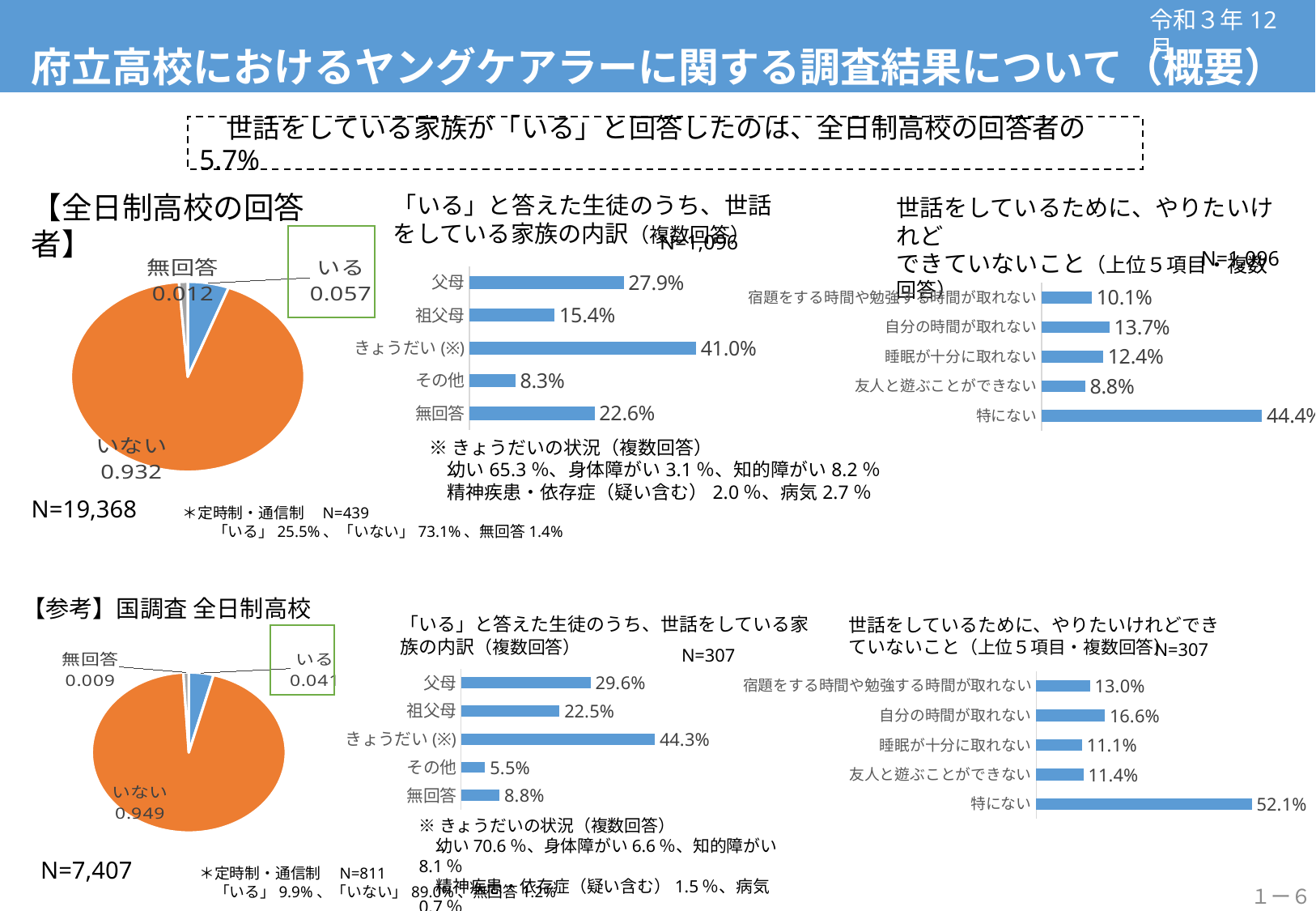
In the bottom-middle bar chart (国調査, N=307), what is the value for きょうだい (※)? 44.3% How many categories are shown in the bottom-right bar chart (国調査, N=307)? 5 In the top-left pie chart (全日制高校の回答者), what share is labelled for いない? 0.932 In the top-middle bar chart (世話をしている家族の内訳, N=1,096), what is the difference between 父母 and その他? 19.6% In the top-right bar chart (やりたいけれどできていないこと, N=1,096), what is the value for 睡眠が十分に取れない? 12.4% In the bottom-right bar chart (国調査, N=307), what is the value for 特にない? 52.1% In the bottom-middle bar chart (国調査, N=307), which is larger, 祖父母 or 無回答? 祖父母 In the top-middle bar chart (世話をしている家族の内訳, N=1,096), which category has the highest value? きょうだい (※) In the top-right bar chart (やりたいけれどできていないこと, N=1,096), which category has the lowest value? 友人と遊ぶことができない In the top-left pie chart (全日制高校の回答者), what share is labelled for いる? 0.057 In the bottom-left pie chart (国調査 全日制高校), what share is labelled for いる? 0.041 In the top-middle bar chart (世話をしている家族の内訳, N=1,096), what is the value for 祖父母? 15.4%